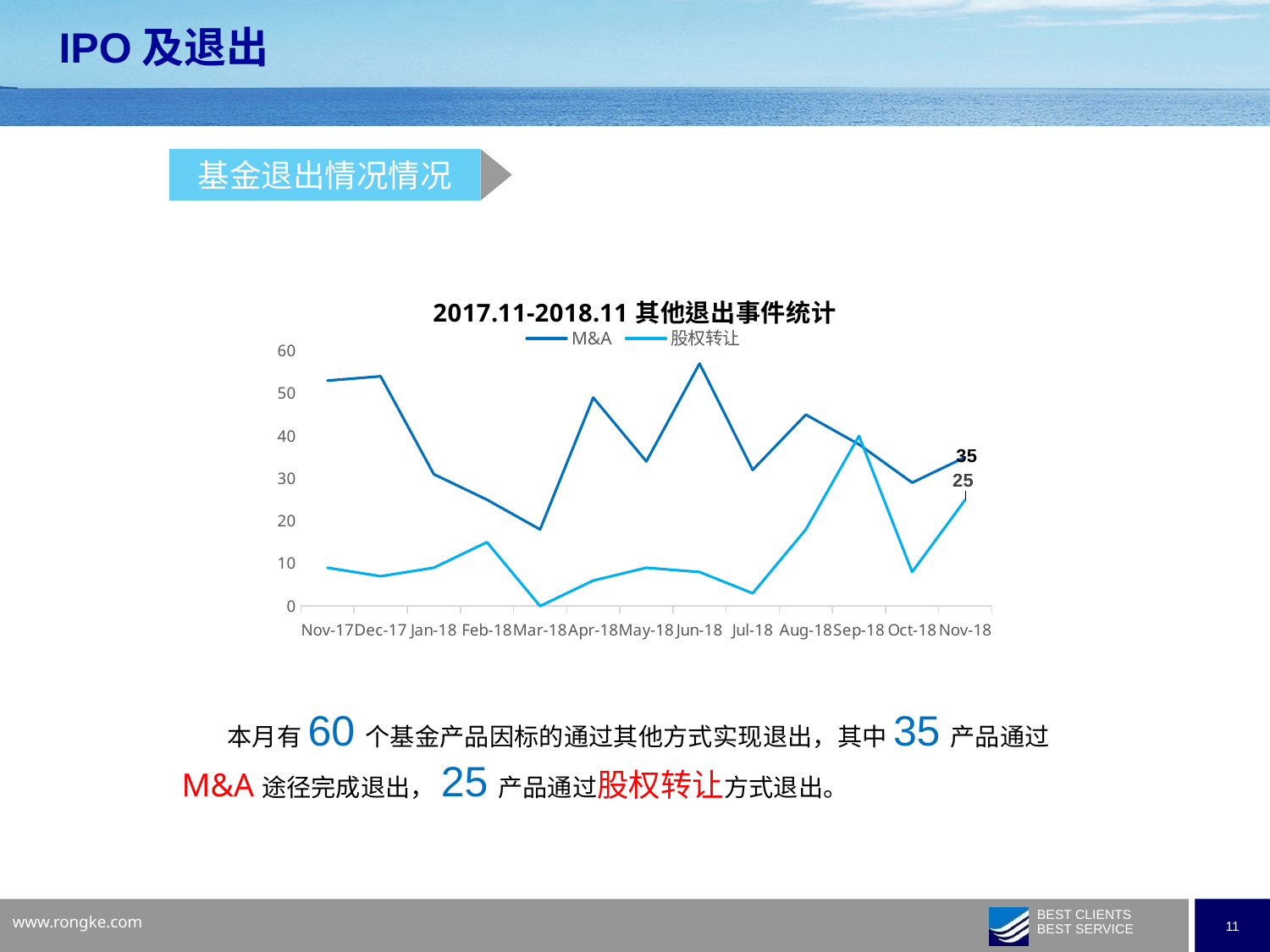
How many months are shown along the x axis of the chart? 13 What is the value of the M&A series for Nov-18? 35 How many series does the chart's legend list? 2 In which month does the M&A series reach its highest value? Jun-18 For Nov-18, which series has the larger value, M&A or 股权转让? M&A What is the title of the chart? 2017.11-2018.11 其他退出事件统计 What is the value of the 股权转让 series for Nov-18? 25 What kind of chart is shown on the slide? Line chart Is the M&A value for Mar-18 greater or less than 20? less In which month does the 股权转让 series reach its lowest value? Mar-18 Is the 股权转让 value for Sep-18 greater or less than 30? greater What is the difference between the M&A value and the 股权转让 value for Nov-18? 10